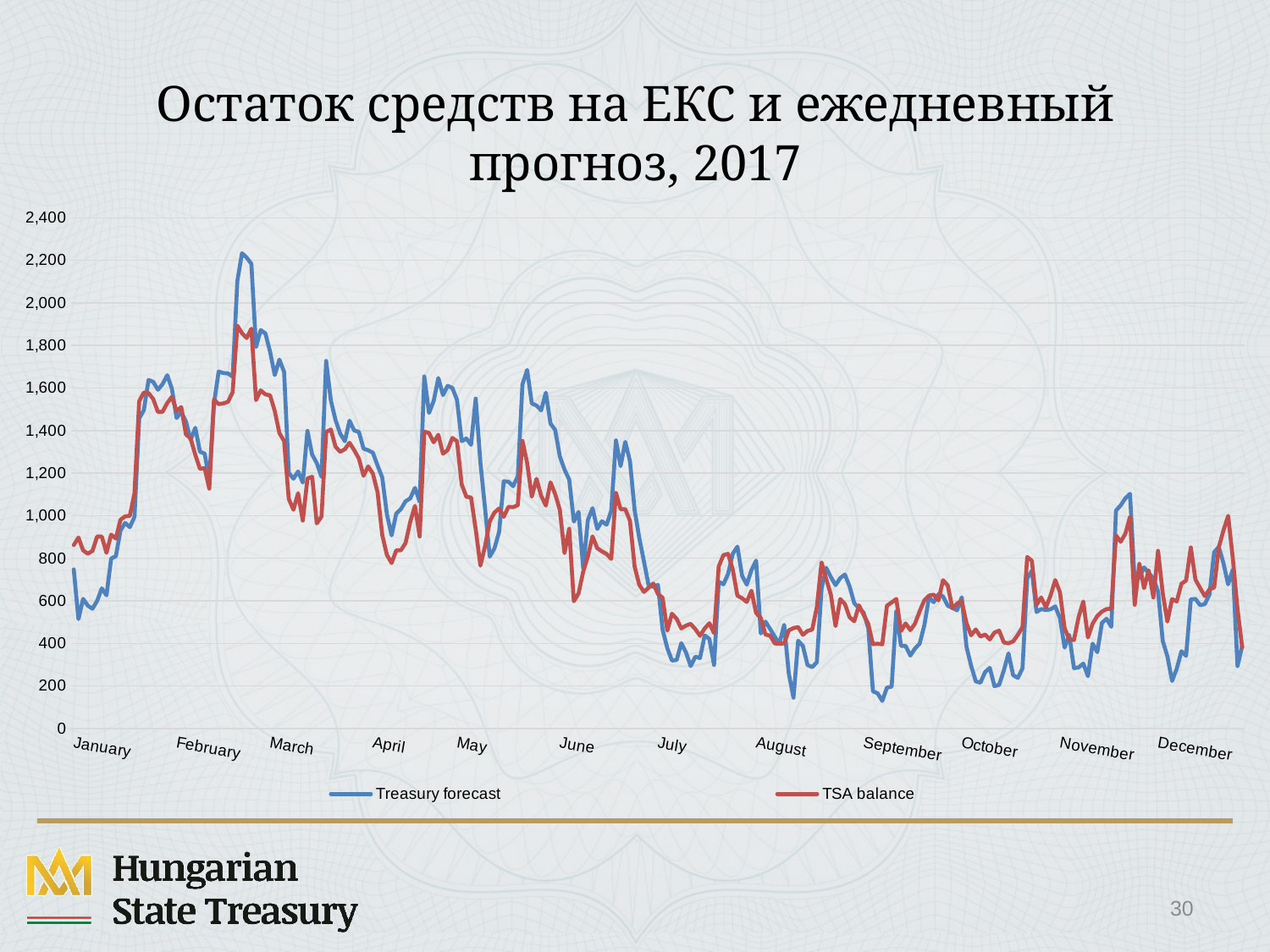
In which month does the Treasury forecast line reach its highest peak? February Is the highest peak of the TSA balance line greater or less than 2,000? less What are the two series named in the legend? Treasury forecast and TSA balance Which series reaches the higher peak in February, Treasury forecast or TSA balance? Treasury forecast Is the highest peak of the Treasury forecast line greater or less than 2,000? greater What is the highest value shown on the y axis? 2,400 How many series does the legend list? 2 What kind of chart is shown on the slide? line chart Is the lowest point of the Treasury forecast line in September greater or less than 200? less Which colour is used for the TSA balance line? red How many months are labelled along the x axis? 12 Overall, do the values rise or fall from the first half of the year to the second half? fall